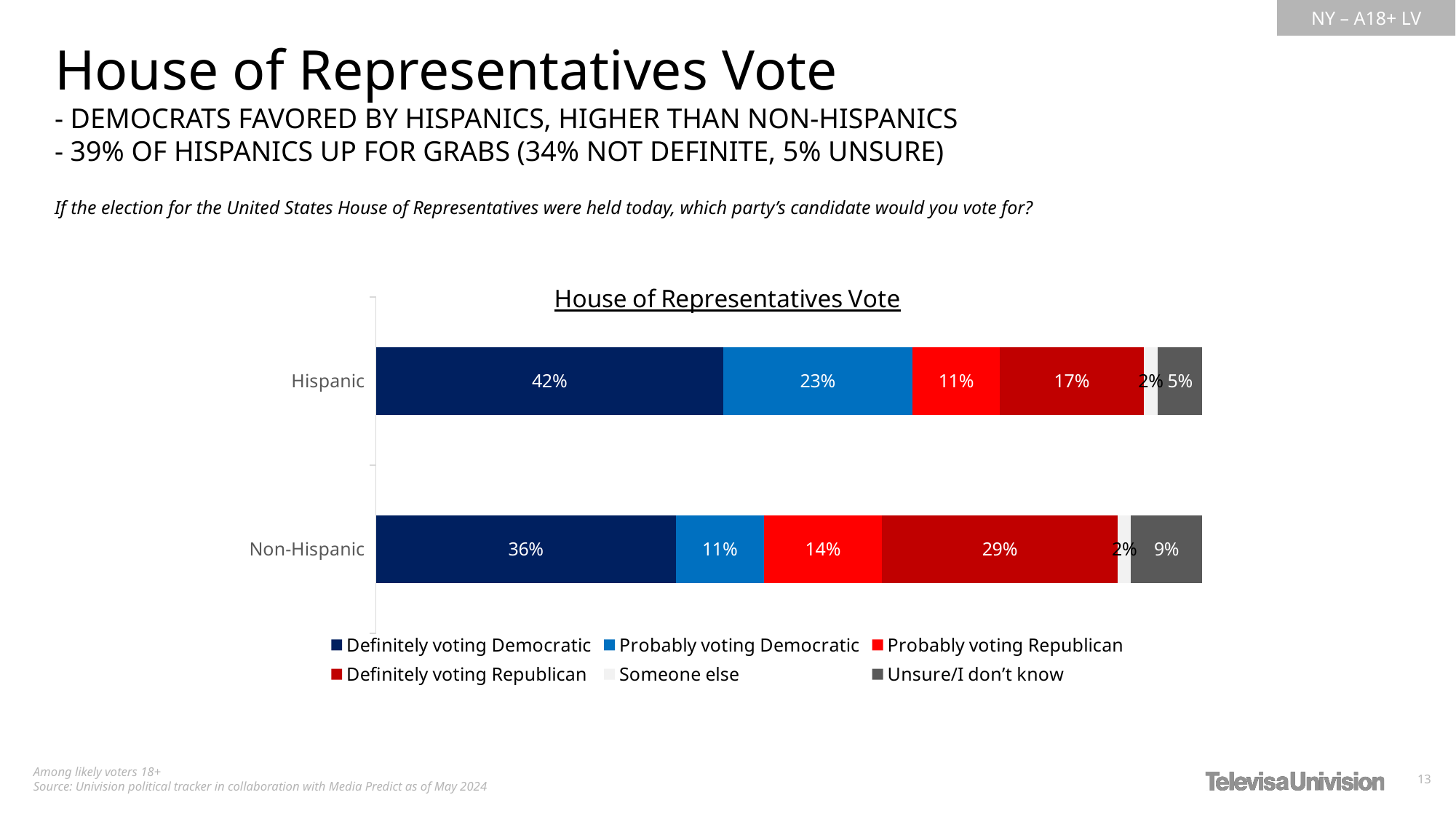
Which response category has the largest share among Hispanic respondents? Definitely voting Democratic What percentage of Hispanic respondents are probably voting Democratic? 23% How many groups (categories) are shown on the chart? 2 What percentage of Hispanic likely voters are definitely voting Democratic? 42% What kind of chart is shown on the slide? Stacked bar chart What percentage of Non-Hispanic likely voters are definitely voting Republican? 29% Which group has the higher share definitely voting Democratic, Hispanic or Non-Hispanic? Hispanic What is the difference between the Hispanic and Non-Hispanic shares probably voting Democratic? 12 percentage points What percentage of Non-Hispanic respondents answered Unsure/I don't know? 9% What is the difference between the Non-Hispanic and Hispanic shares definitely voting Republican? 12 percentage points Which response category has the smallest share among Non-Hispanic respondents? Someone else How many series does the legend list? 6